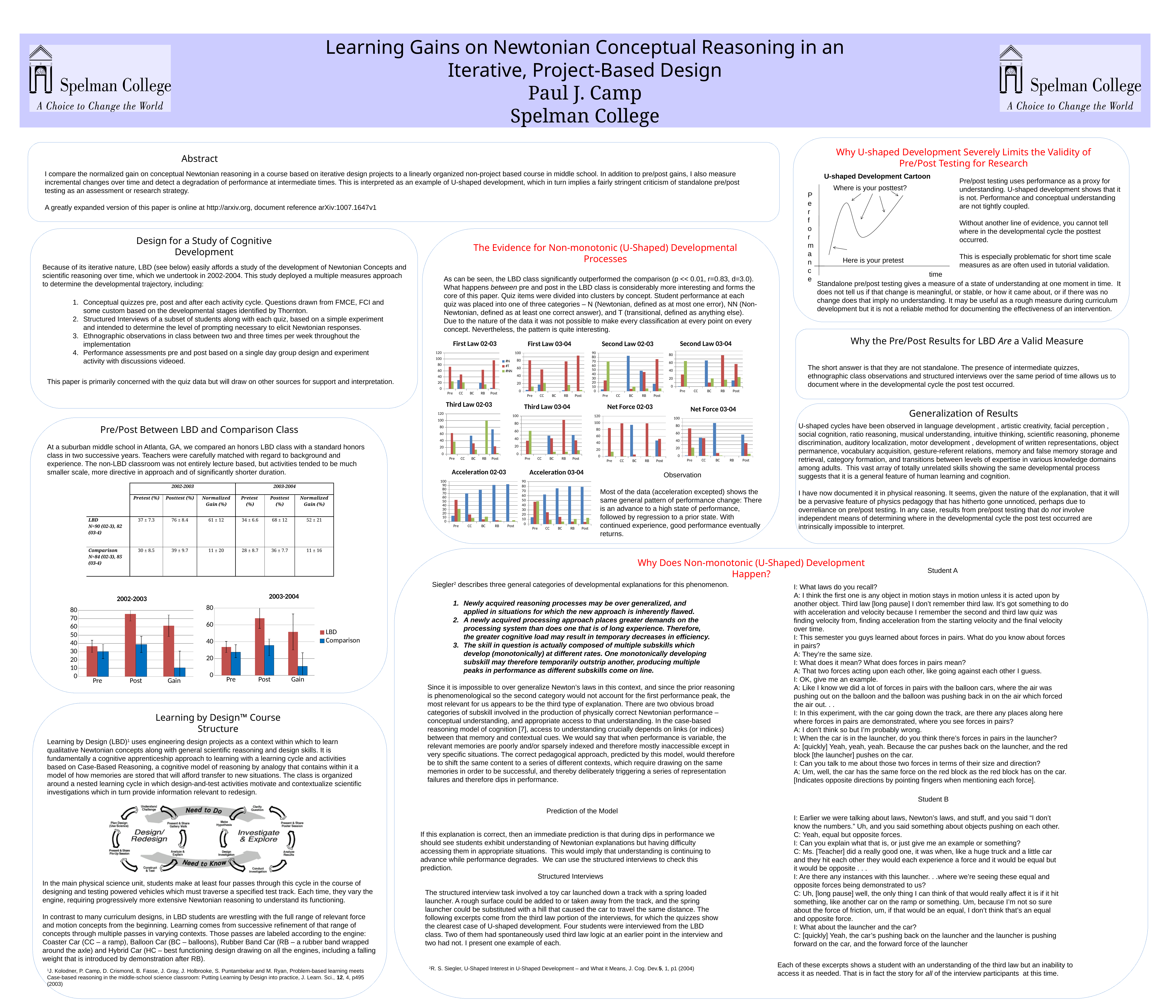
What kind of chart is the 2002-2003 chart in the Pre/Post Between LBD and Comparison Class section? bar chart In the 2002-2003 chart, which is larger for Post: LBD or Comparison? LBD In the 2003-2004 chart, which category has the lowest Comparison bar? Gain How many series does the legend of the First Law 02-03 chart list? 3 In the 2003-2004 chart, is the LBD value for Post greater or less than 60? greater In the 2002-2003 chart, is the LBD value for Post greater or less than 70? greater How many categories are shown on the x axis of the 2003-2004 chart? 3 In the 2003-2004 chart, which is larger for Gain: LBD or Comparison? LBD In the 2002-2003 chart, is the Comparison value for Gain greater or less than 20? less In the 2002-2003 chart, which category has the highest LBD bar? Post